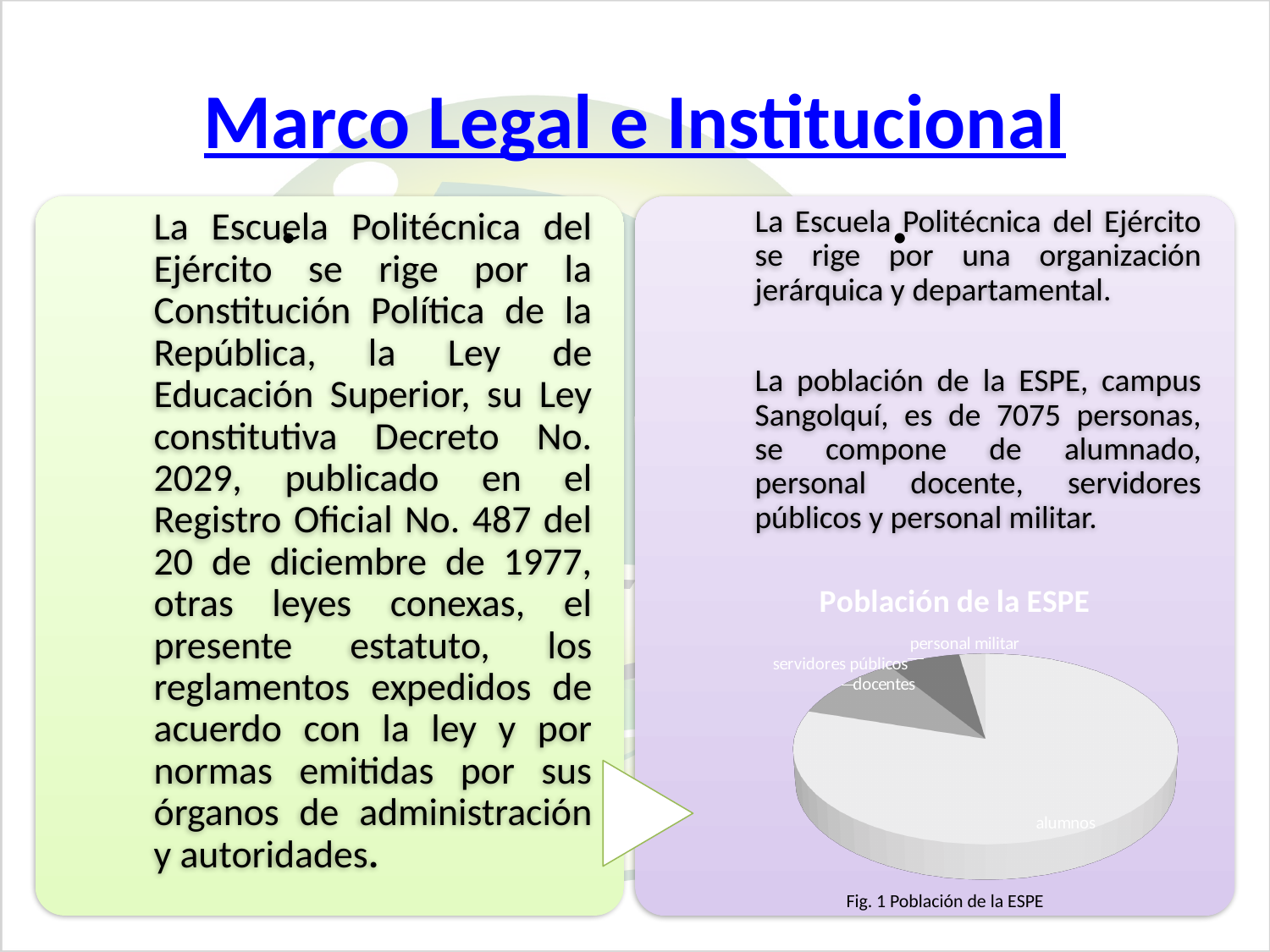
Which slice is larger in the pie chart, alumnos or docentes? alumnos How many slices does the pie chart have? 4 What is the title of the pie chart? Población de la ESPE Which category has the largest slice in the pie chart? alumnos Which slice is larger in the pie chart, alumnos or personal militar? alumnos What kind of chart is shown on the slide? pie chart What is the figure caption below the pie chart? Fig. 1 Población de la ESPE